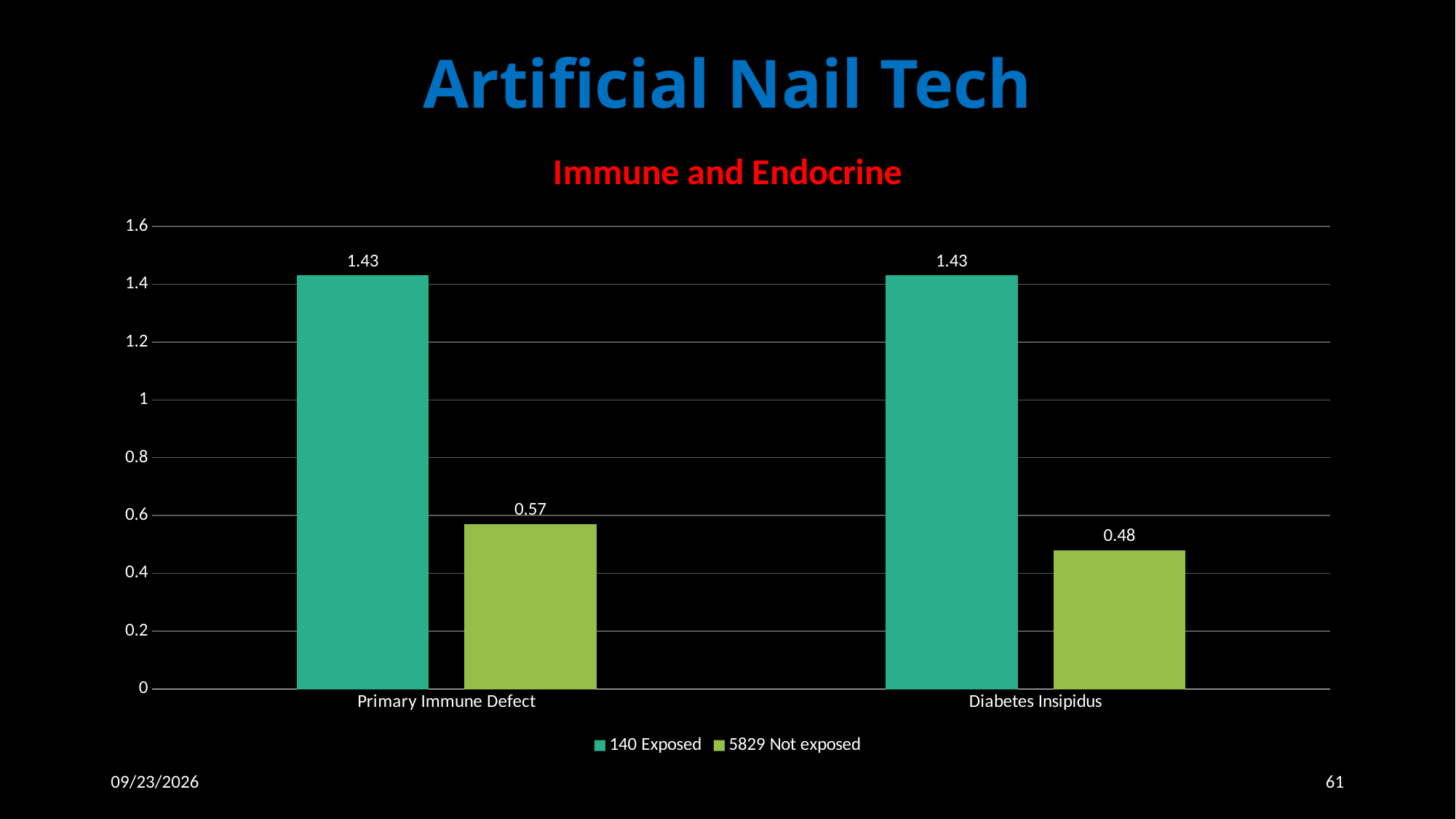
What is the difference between the 140 Exposed and 5829 Not exposed values for Primary Immune Defect? 0.86 What is the value for 140 Exposed in the Diabetes Insipidus category? 1.43 Is the value for 5829 Not exposed in Diabetes Insipidus greater or less than 0.6? less Which is larger for Diabetes Insipidus: the 140 Exposed value or the 5829 Not exposed value? 140 Exposed Which category has the lowest value for 5829 Not exposed? Diabetes Insipidus How many series does the legend list? 2 What kind of chart is shown on the slide? bar chart What is the value for 5829 Not exposed in the Primary Immune Defect category? 0.57 How many categories are shown on the x axis? 2 What is the value for 5829 Not exposed in the Diabetes Insipidus category? 0.48 What is the value for 140 Exposed in the Primary Immune Defect category? 1.43 What is the difference between the 5829 Not exposed values for Primary Immune Defect and Diabetes Insipidus? 0.09